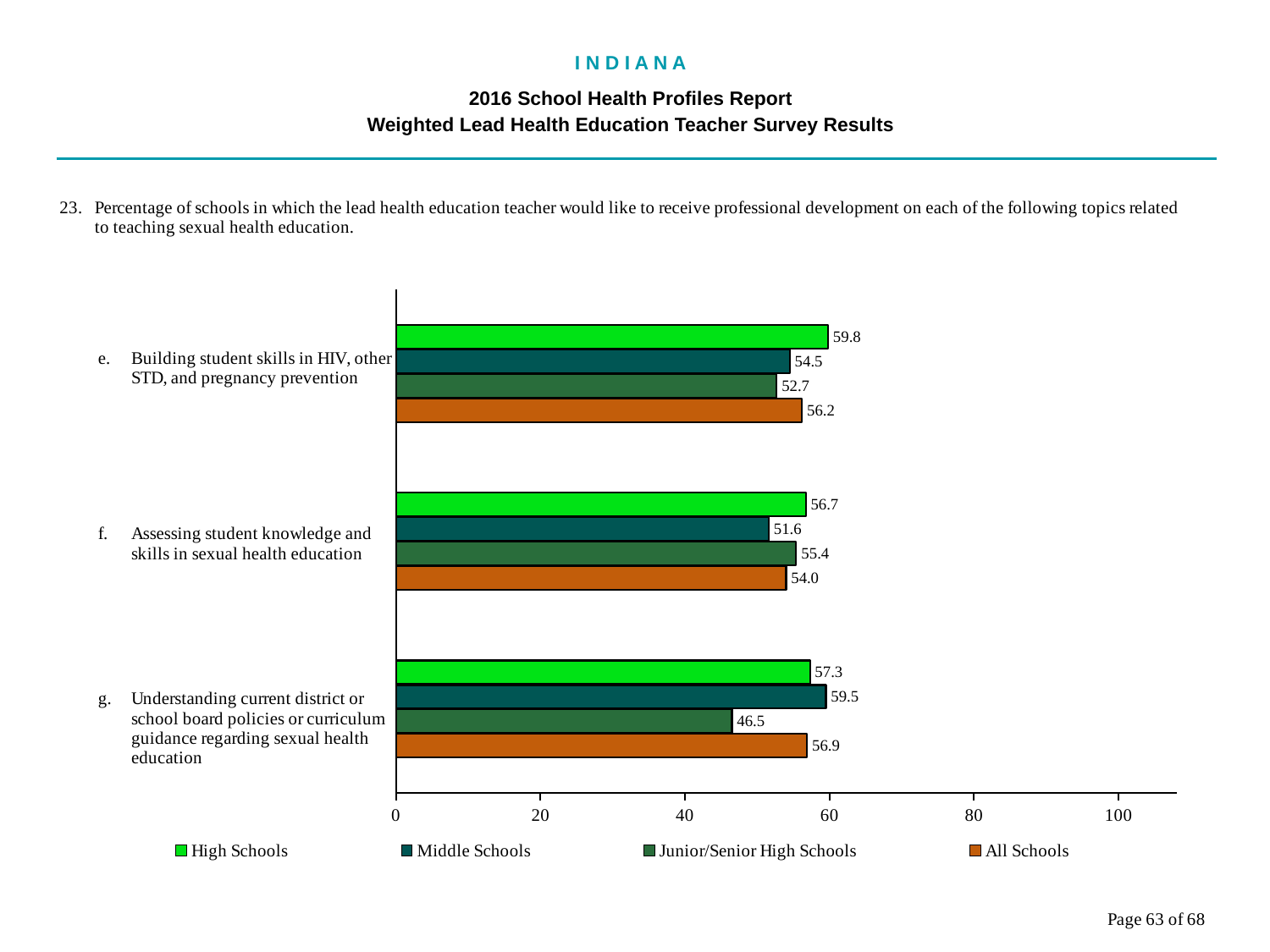
How many series does the legend list? 4 What is the All Schools value for topic g? 56.9 Is the Junior/Senior High Schools value for topic g greater or less than 60? less What is the value for Middle Schools for topic g, understanding current district or school board policies or curriculum guidance regarding sexual health education? 59.5 Which school type has the lowest value for topic g? Junior/Senior High Schools What is the difference between the High Schools and Middle Schools values for topic e? 5.3 How many topics (categories) are shown on the chart? 3 What is the value for Junior/Senior High Schools for topic f, assessing student knowledge and skills in sexual health education? 55.4 Which is larger for topic f: the High Schools value or the Middle Schools value? High Schools What is the value for High Schools for topic e, building student skills in HIV, other STD, and pregnancy prevention? 59.8 What kind of chart is shown on the slide? Bar chart Which school type has the highest value for topic e? High Schools